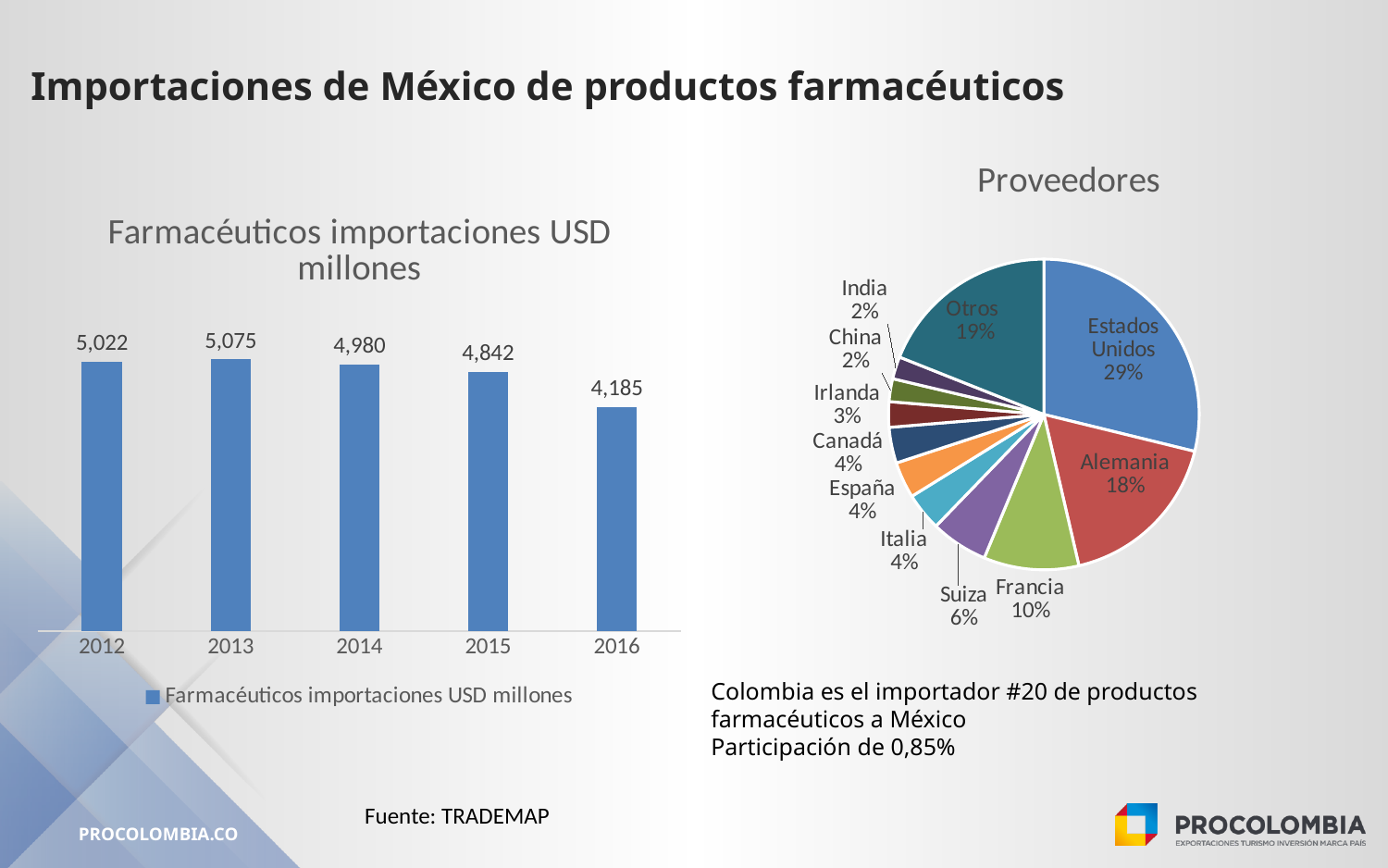
In the 'Proveedores' pie chart, what share does Estados Unidos have? 29% In the 'Farmacéuticos importaciones USD millones' bar chart, which year has the lowest value? 2016 In the 'Farmacéuticos importaciones USD millones' bar chart, which year has the highest value? 2013 In the 'Farmacéuticos importaciones USD millones' bar chart, what is the value for 2013? 5,075 In the 'Farmacéuticos importaciones USD millones' bar chart, what is the difference between the values for 2012 and 2016? 837 In the 'Proveedores' pie chart, what share does Francia have? 10% In the 'Proveedores' pie chart, which is larger, Alemania or Suiza? Alemania In the 'Farmacéuticos importaciones USD millones' bar chart, how many years are shown? 5 What kind of chart is 'Proveedores'? pie chart In the 'Farmacéuticos importaciones USD millones' bar chart, what is the value for 2016? 4,185 In the 'Farmacéuticos importaciones USD millones' bar chart, do the values rise or fall from 2013 to 2016? fall What kind of chart is 'Farmacéuticos importaciones USD millones'? bar chart